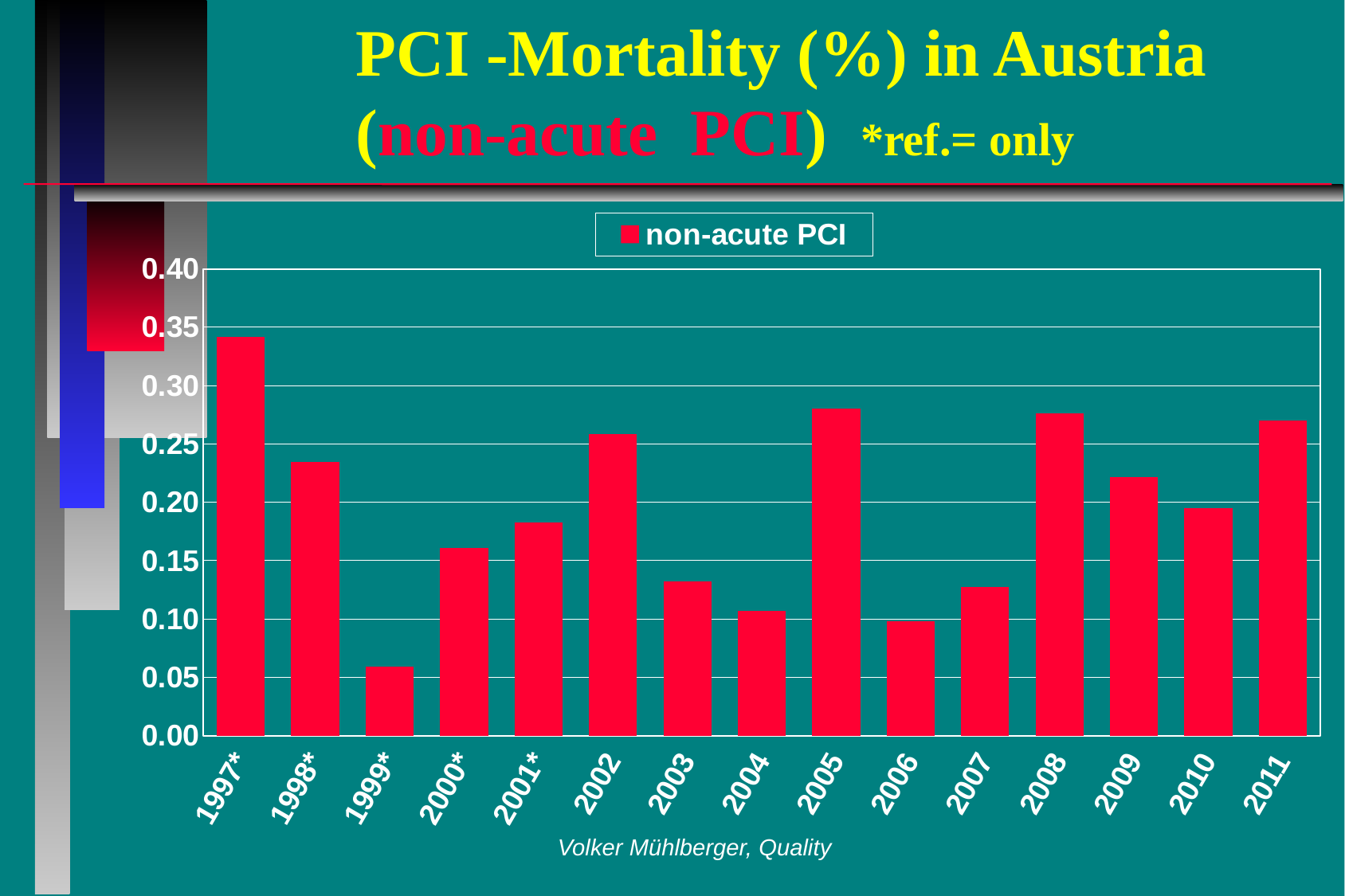
Is the value for 2005 greater or less than 0.25? greater Which year has the lowest non-acute PCI mortality? 1999* How many years are shown on the x axis of the chart? 15 Which year has the highest non-acute PCI mortality? 1997* What kind of chart is shown on the slide? bar chart Is the value for 1997* greater or less than 0.30? greater Which year has the larger value, 1998* or 2003? 1998* Is the value for 2003 greater or less than 0.15? less What is the series name shown in the legend? non-acute PCI Which year has the larger value, 2005 or 2006? 2005 How many series does the legend list? 1